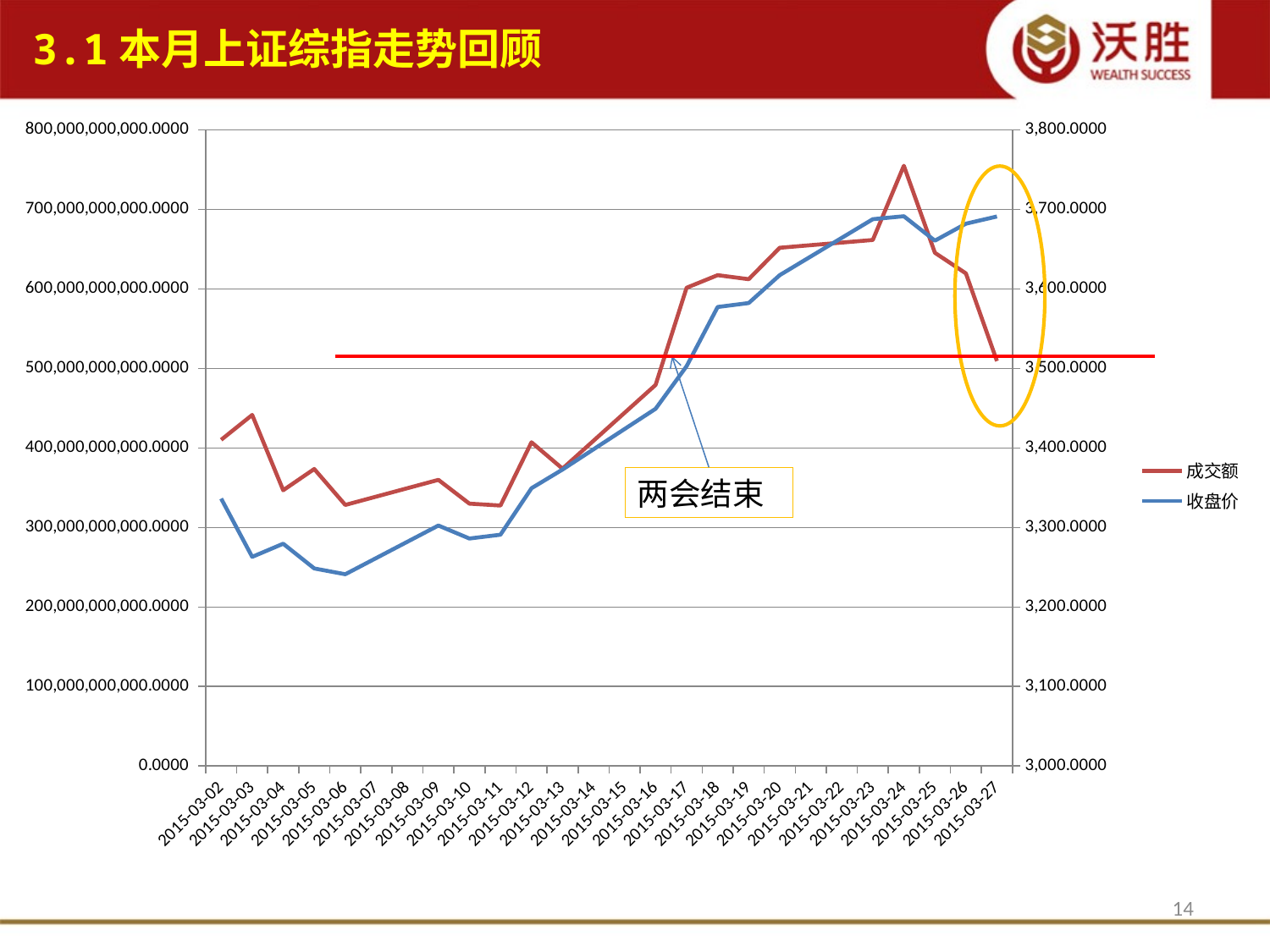
On which date does 成交额 reach its highest value? 2015-03-24 Is the value of 收盘价 on 2015-03-02 greater or less than 3,400.0000? less What kind of chart is shown on the slide? line chart Does 成交额 rise or fall from 2015-03-24 to 2015-03-27? fall What text is in the annotation box pointing at the chart? 两会结束 How many dates are shown on the x axis? 26 How many series does the legend list? 2 Which is larger, 成交额 on 2015-03-24 or 成交额 on 2015-03-27? 2015-03-24 Is the value of 收盘价 on 2015-03-27 greater or less than 3,600.0000? greater Is the value of 成交额 on 2015-03-24 greater or less than 700,000,000,000.0000? greater Does 收盘价 rise or fall from 2015-03-12 to 2015-03-24? rise